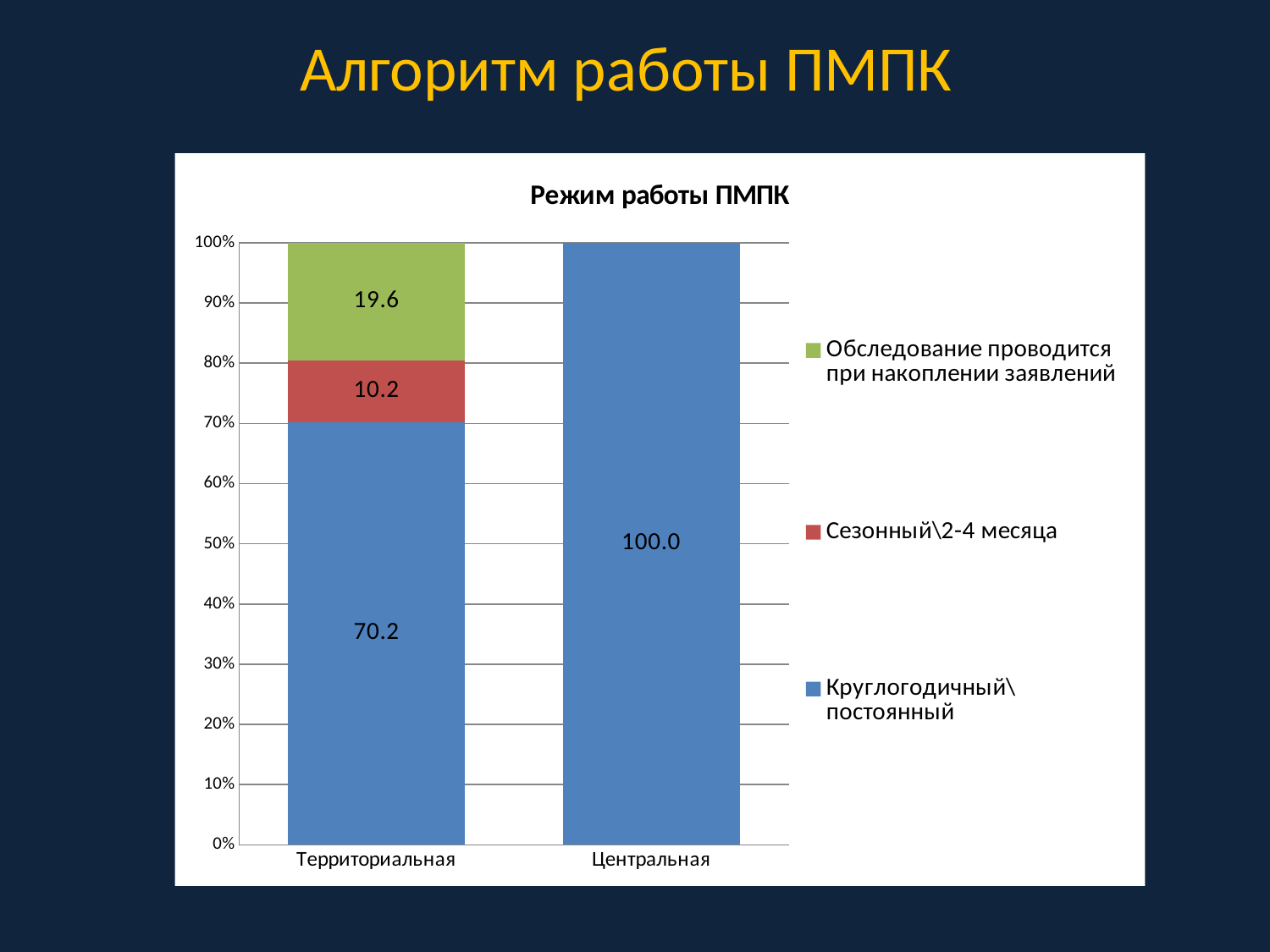
What is the value of the Круглогодичный\постоянный series for Территориальная? 70.2 How many categories are shown on the x axis? 2 What is the difference between the Обследование проводится при накоплении заявлений value and the Сезонный\2-4 месяца value for Территориальная? 9.4 What is the value of the Сезонный\2-4 месяца series for Территориальная? 10.2 Which series has the largest value for Территориальная? Круглогодичный\постоянный What is the value of the Обследование проводится при накоплении заявлений series for Территориальная? 19.6 What is the total of the stacked bar for Территориальная? 100.0 What type of chart is shown on the slide? Stacked bar chart What is the value of the Круглогодичный\постоянный series for Центральная? 100.0 Which category has the larger value for the Круглогодичный\постоянный series, Территориальная or Центральная? Центральная Which series has the smallest value for Территориальная? Сезонный\2-4 месяца How many series does the legend list? 3